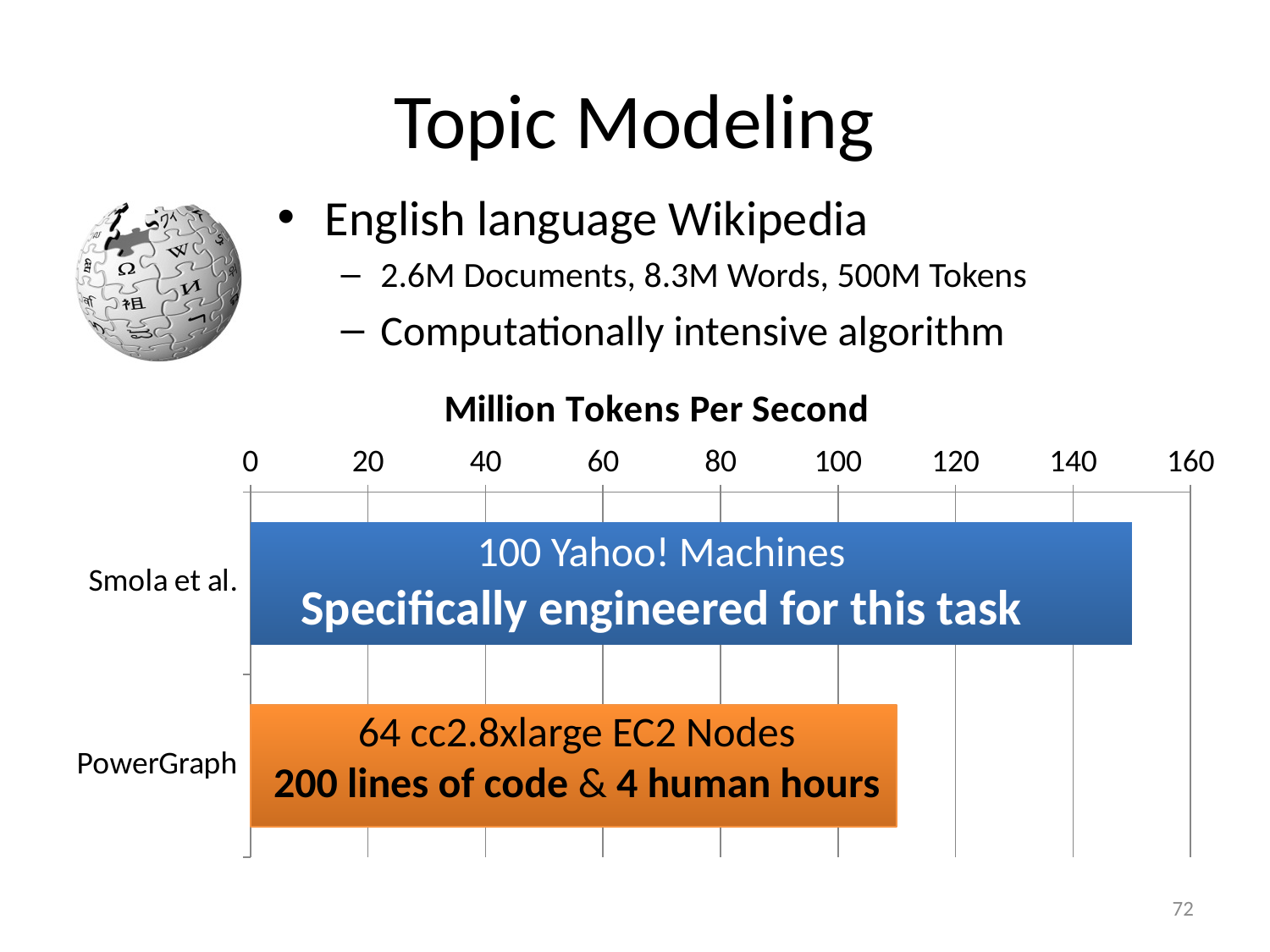
Is the value for PowerGraph greater or less than 120? less Which has a larger value, Smola et al. or PowerGraph? Smola et al. Is the value for Smola et al. greater or less than 140? greater Is the value for PowerGraph greater or less than 100? greater What is the maximum value shown on the chart's horizontal axis? 160 Which category has the lowest value in the chart? PowerGraph What is the title of the chart? Million Tokens Per Second Which category has the highest value in the chart? Smola et al. How many categories (bars) does the chart show? 2 What kind of chart is shown on the slide? bar chart